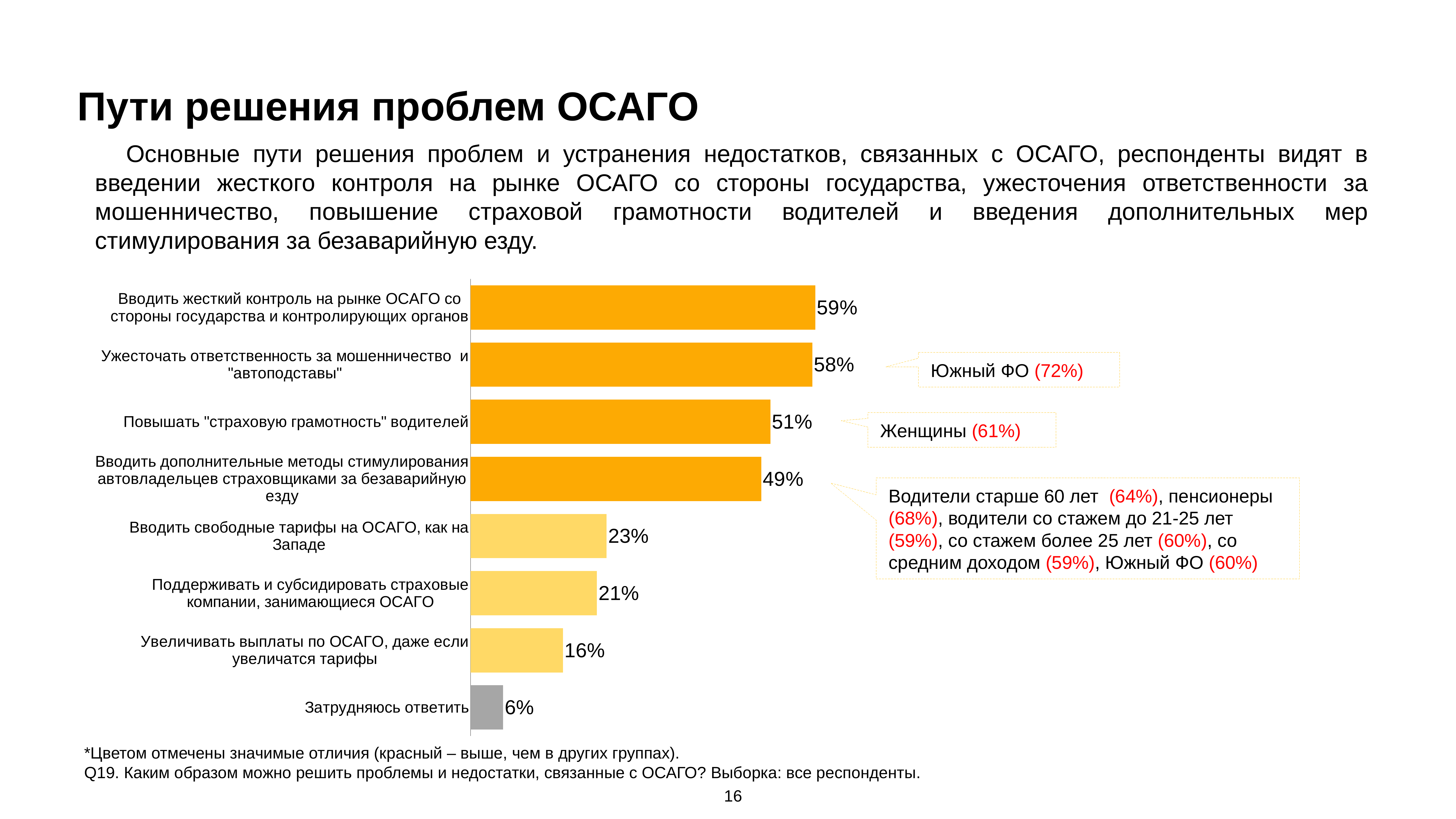
Which is larger: "Поддерживать и субсидировать страховые компании, занимающиеся ОСАГО" or "Увеличивать выплаты по ОСАГО, даже если увеличатся тарифы"? Поддерживать и субсидировать страховые компании, занимающиеся ОСАГО Which category has the highest value? Вводить жесткий контроль на рынке ОСАГО со стороны государства и контролирующих органов What is the value for "Вводить жесткий контроль на рынке ОСАГО со стороны государства и контролирующих органов"? 59% What is the value for "Повышать "страховую грамотность" водителей"? 51% According to the callout next to the chart, what is the value for "Южный ФО" on "Ужесточать ответственность за мошенничество и "автоподставы""? 72% What is the value for "Затрудняюсь ответить"? 6% Which category has the lowest value? Затрудняюсь ответить How many categories (bars) does the chart show? 8 What is the difference between the highest value (59%) and the lowest value (6%)? 53% What type of chart is shown on the slide? bar chart What is the difference between "Ужесточать ответственность за мошенничество и "автоподставы"" (58%) and "Вводить дополнительные методы стимулирования автовладельцев страховщиками за безаварийную езду" (49%)? 9% What is the value for "Вводить свободные тарифы на ОСАГО, как на Западе"? 23%